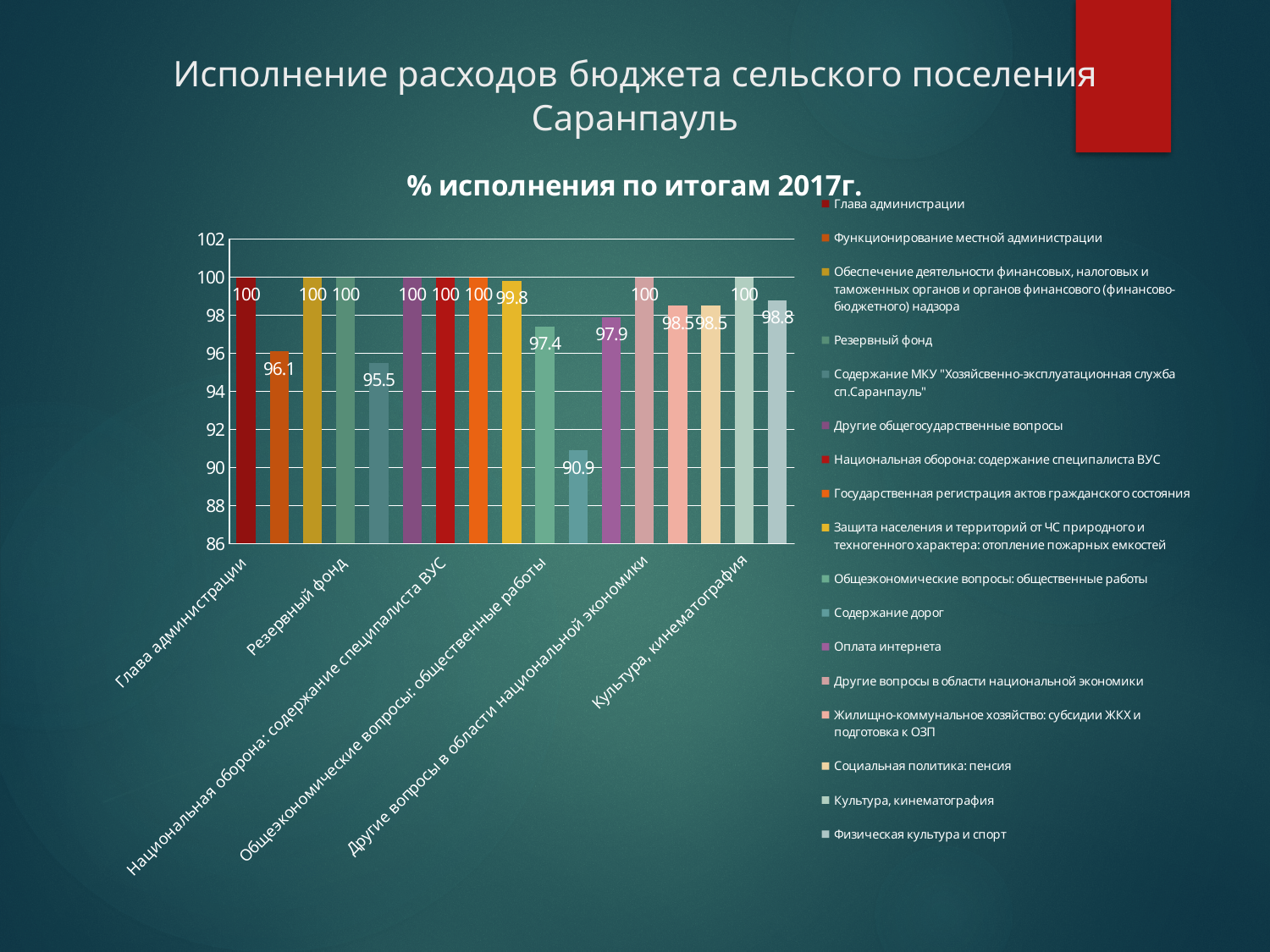
What is the value for Оплата интернета? 97.9 Which is larger: the value for Общеэкономические вопросы: общественные работы or the value for Содержание МКУ "Хозяйсвенно-эксплуатационная служба сп.Саранпауль"? Общеэкономические вопросы: общественные работы What is the difference between the value for Глава администрации and the value for Содержание дорог? 9.1 What is the value for Содержание дорог? 90.9 What type of chart is shown on the slide? bar chart Is the value for Содержание дорог greater or less than 92? less How many entries does the chart legend list? 17 What is the value for Содержание МКУ "Хозяйсвенно-эксплуатационная служба сп.Саранпауль"? 95.5 Which category has the lowest value in the chart? Содержание дорог What is the value for Физическая культура и спорт? 98.8 What is the title of the chart? % исполнения по итогам 2017г. What is the value for Функционирование местной администрации? 96.1